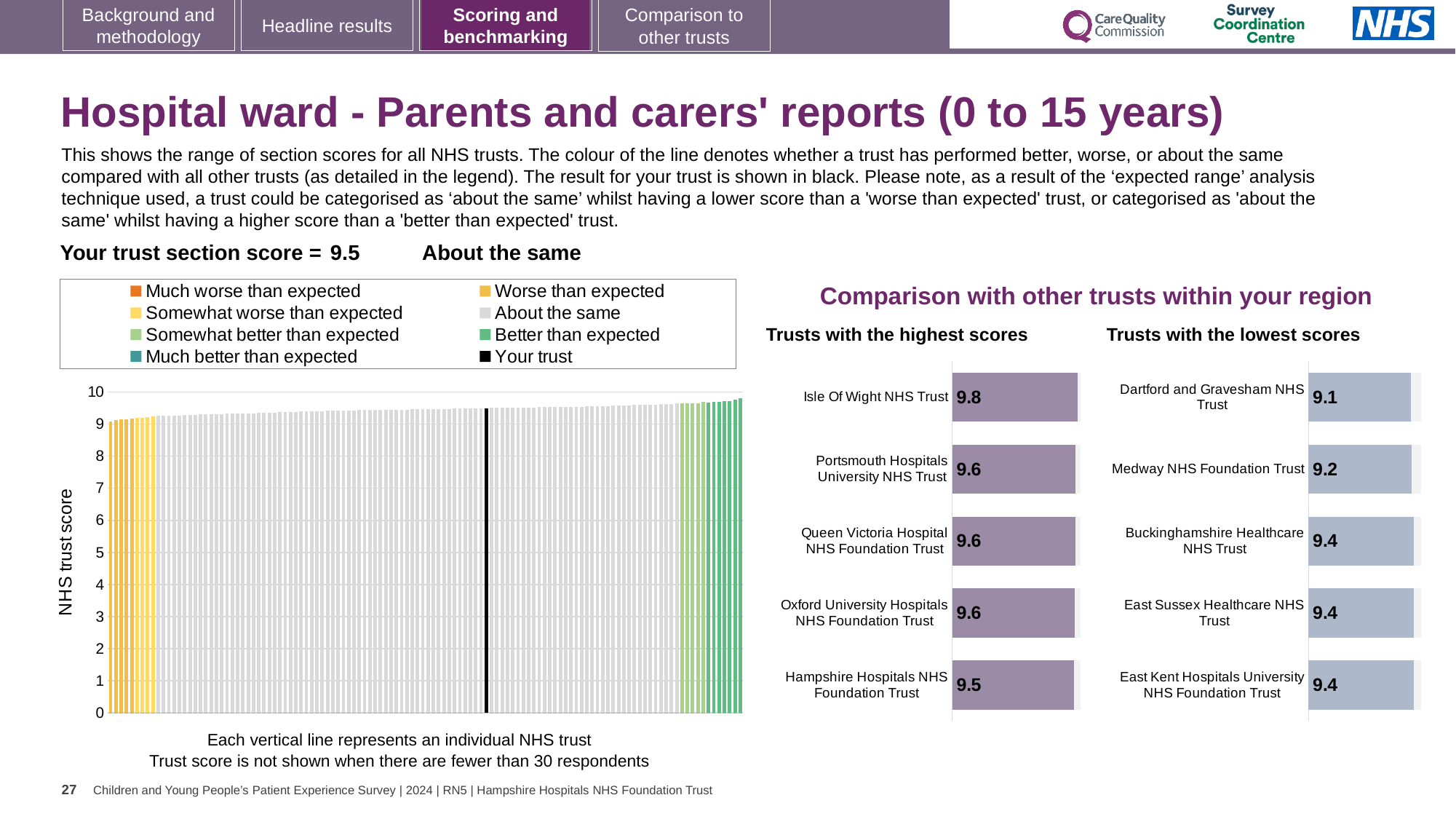
In the 'Trusts with the lowest scores' chart, which has the larger score: Medway NHS Foundation Trust or Dartford and Gravesham NHS Trust? Medway NHS Foundation Trust In the 'Trusts with the highest scores' chart, which trust has the highest score? Isle Of Wight NHS Trust In the 'Trusts with the highest scores' chart, what is the difference between the scores of Isle Of Wight NHS Trust and Hampshire Hospitals NHS Foundation Trust? 0.3 In the 'Trusts with the highest scores' chart, what is the score for Isle Of Wight NHS Trust? 9.8 In the 'Trusts with the lowest scores' chart, what is the score for Dartford and Gravesham NHS Trust? 9.1 How many trusts are listed in the 'Trusts with the highest scores' chart? 5 In the 'Trusts with the lowest scores' chart, which trust has the lowest score? Dartford and Gravesham NHS Trust How many entries does the legend of the left chart list? 8 In the 'Trusts with the lowest scores' chart, what is the score for Medway NHS Foundation Trust? 9.2 In the left chart showing the range of section scores, is the value for your trust (the black line) greater or less than 9? greater What kind of chart is the 'Trusts with the lowest scores' chart? bar chart In the 'Trusts with the highest scores' chart, what is the score for Hampshire Hospitals NHS Foundation Trust? 9.5